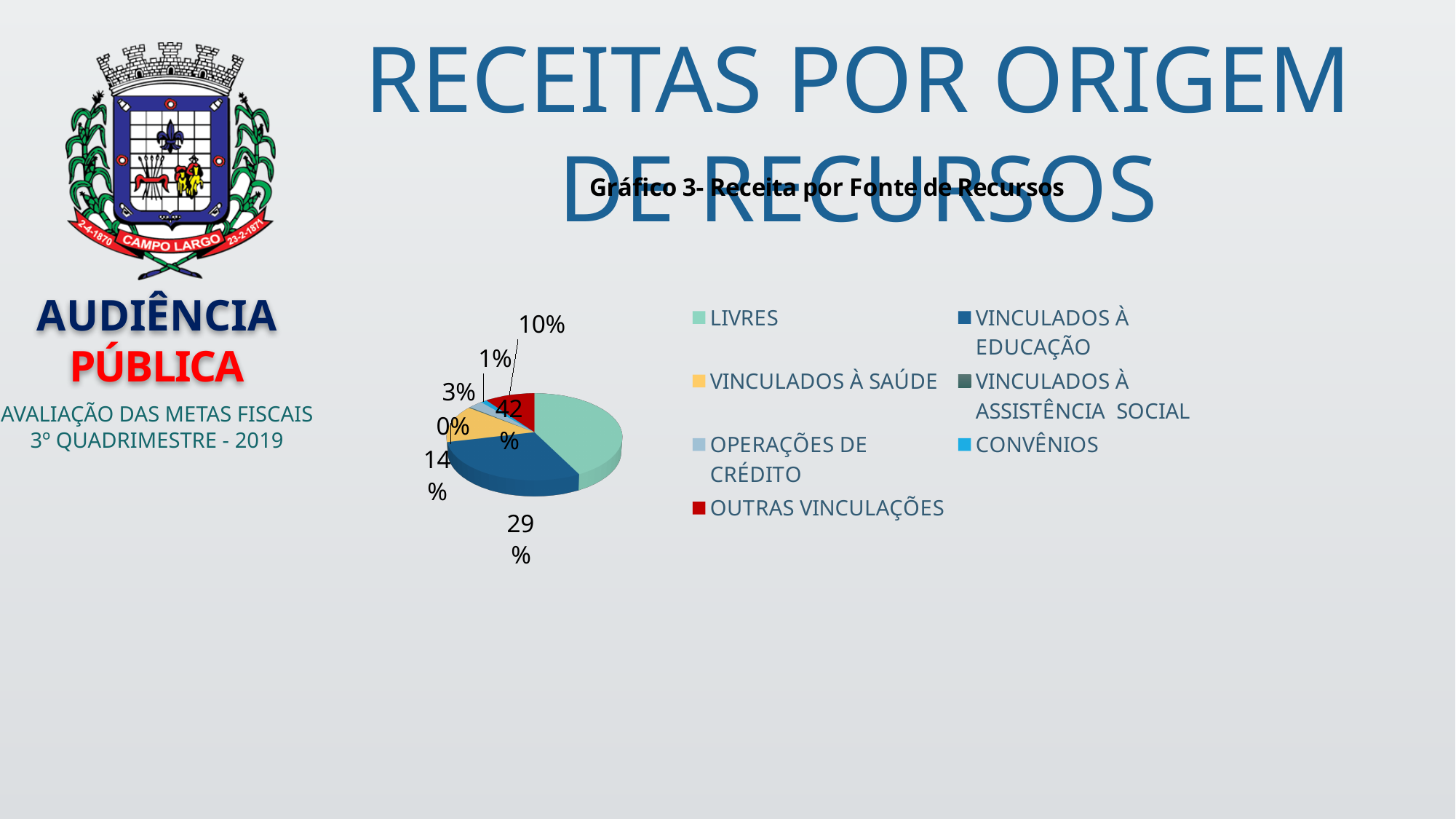
Which is larger, the share for VINCULADOS À SAÚDE or the share for OUTRAS VINCULAÇÕES? VINCULADOS À SAÚDE Which category has the smallest slice of the pie? VINCULADOS À ASSISTÊNCIA SOCIAL What share of the pie does LIVRES represent? 42% How many categories does the legend of the pie chart list? 7 What share of the pie does OUTRAS VINCULAÇÕES represent? 10% What is the title of the chart? Gráfico 3- Receita por Fonte de Recursos What kind of chart is shown on the slide? pie chart What is the difference in percentage points between LIVRES and VINCULADOS À EDUCAÇÃO? 13 What share of the pie does VINCULADOS À EDUCAÇÃO represent? 29% Which category has the largest slice of the pie? LIVRES